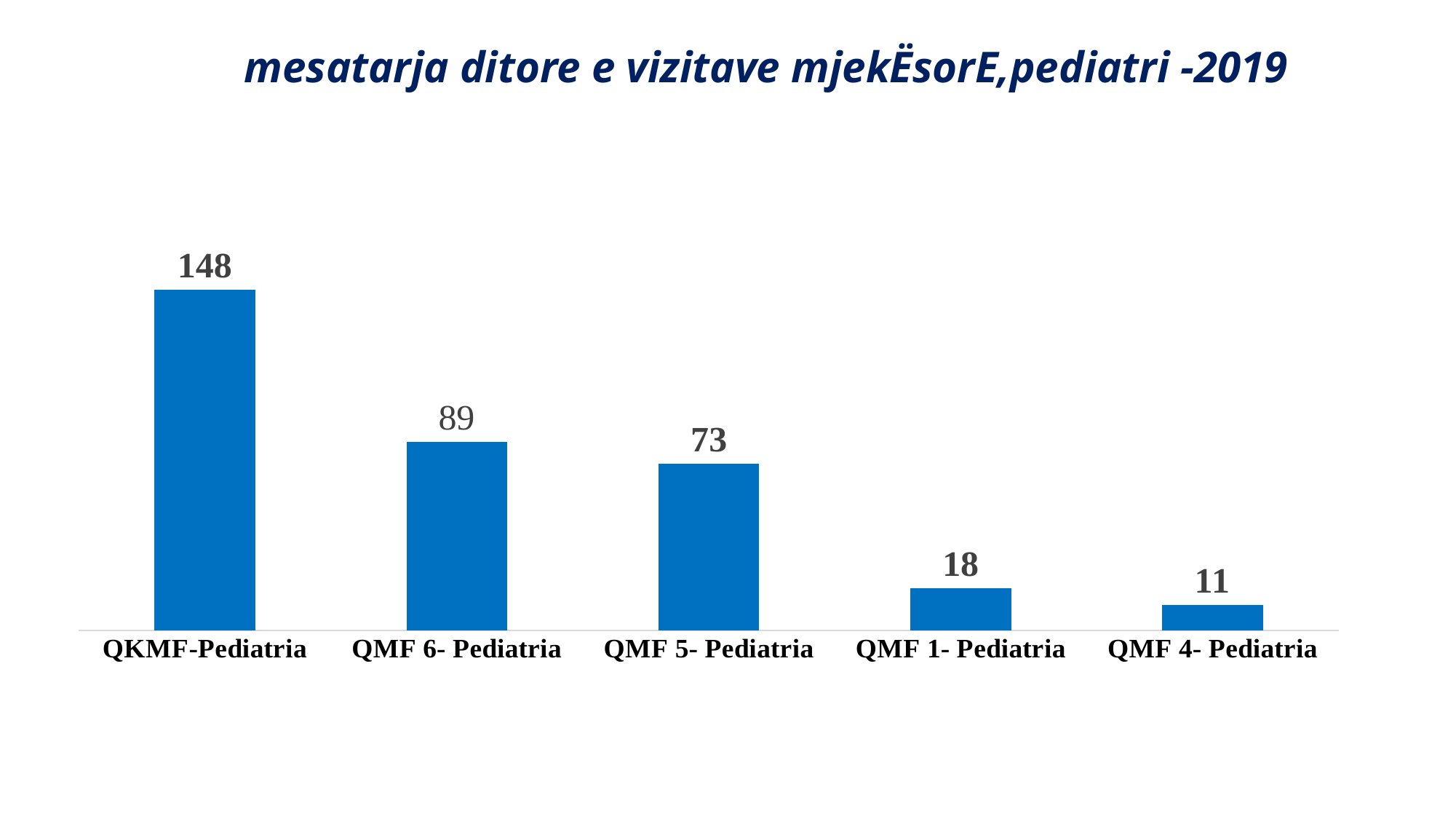
What is the value for QMF 4- Pediatria? 11 What is the difference between the values for QMF 1- Pediatria and QMF 4- Pediatria? 7 What is the difference between the values for QKMF-Pediatria and QMF 6- Pediatria? 59 What is the value for QMF 5- Pediatria? 73 What is the value for QMF 1- Pediatria? 18 What kind of chart is shown on the slide? Bar chart What is the value for QMF 6- Pediatria? 89 Which is larger, the value for QMF 6- Pediatria or QMF 5- Pediatria? QMF 6- Pediatria What is the value for QKMF-Pediatria? 148 Which category has the lowest value? QMF 4- Pediatria Which category has the highest value? QKMF-Pediatria How many categories are shown in the chart? 5